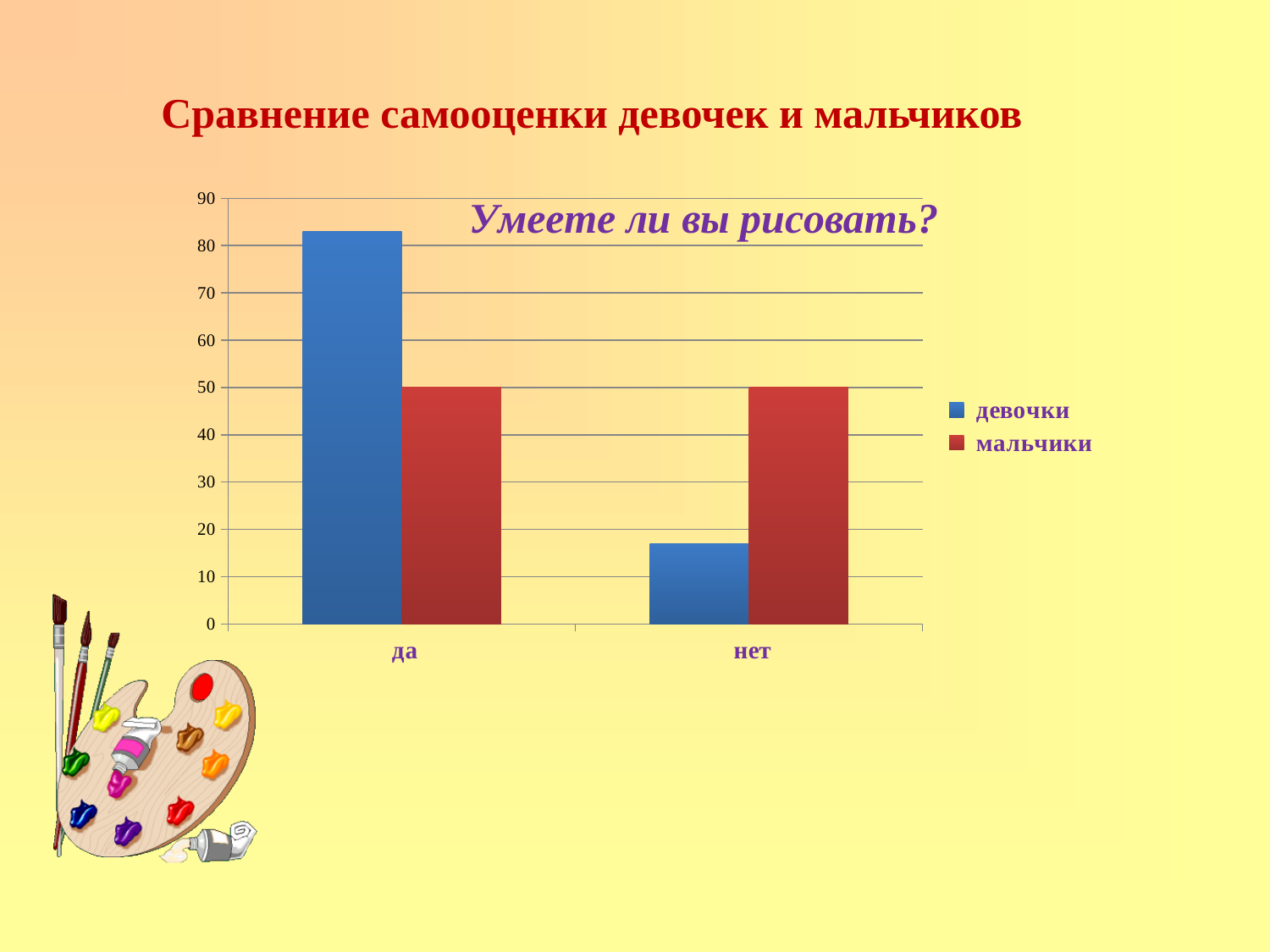
Is the value for девочки in the category да greater or less than 80? greater What kind of chart is shown on the slide? bar chart Is the value for девочки in the category нет greater or less than 20? less What is the title shown inside the chart area? Умеете ли вы рисовать? What is the value for мальчики in the category да? 50 How many series does the legend list? 2 In the category нет, which series has the larger value, девочки or мальчики? мальчики What is the value for мальчики in the category нет? 50 Which colour represents the series мальчики? red How many categories are shown on the x axis? 2 Which category has the highest value for девочки? да In the category да, which series has the larger value, девочки or мальчики? девочки